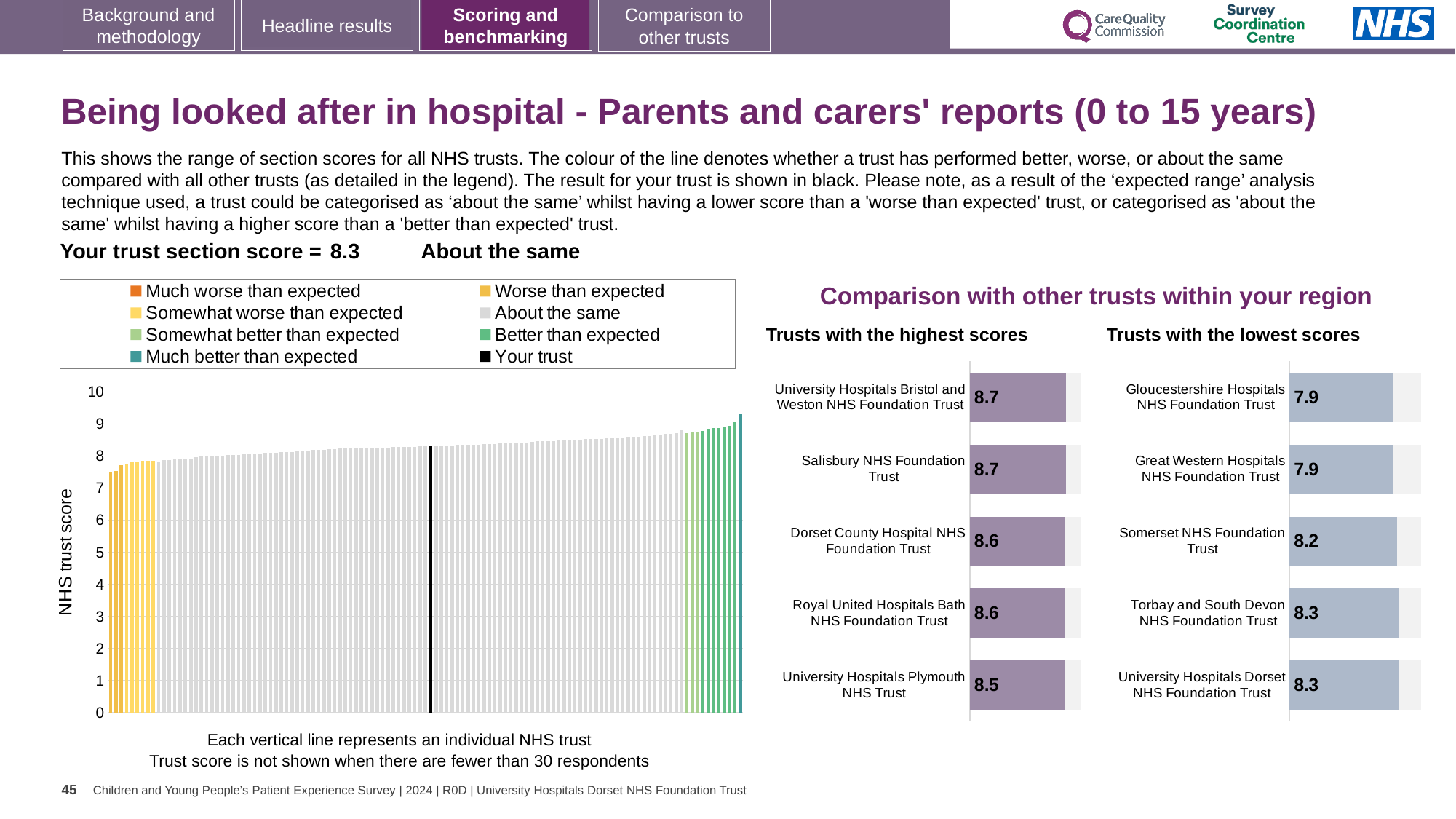
In the 'Trusts with the highest scores' chart, what is the difference between the scores of University Hospitals Bristol and Weston NHS Foundation Trust and University Hospitals Plymouth NHS Trust? 0.2 In the 'Trusts with the highest scores' chart, what is the score for Dorset County Hospital NHS Foundation Trust? 8.6 What is your trust's section score shown on the slide? 8.3 How many trusts are listed in the 'Trusts with the lowest scores' chart? 5 In the large chart on the left, do the trust scores rise or fall from left to right? Rise In the large chart on the left, is the value for the black 'Your trust' bar greater or less than 5? greater What kind of chart is the large chart on the left showing NHS trust scores? Bar chart In the 'Trusts with the lowest scores' chart, what is the score for Somerset NHS Foundation Trust? 8.2 In the 'Trusts with the lowest scores' chart, which has the higher score: Somerset NHS Foundation Trust or Gloucestershire Hospitals NHS Foundation Trust? Somerset NHS Foundation Trust What is the label on the vertical axis of the large chart on the left? NHS trust score How many entries does the legend above the large chart on the left list? 8 In the 'Trusts with the highest scores' chart, which trust has the lowest score? University Hospitals Plymouth NHS Trust